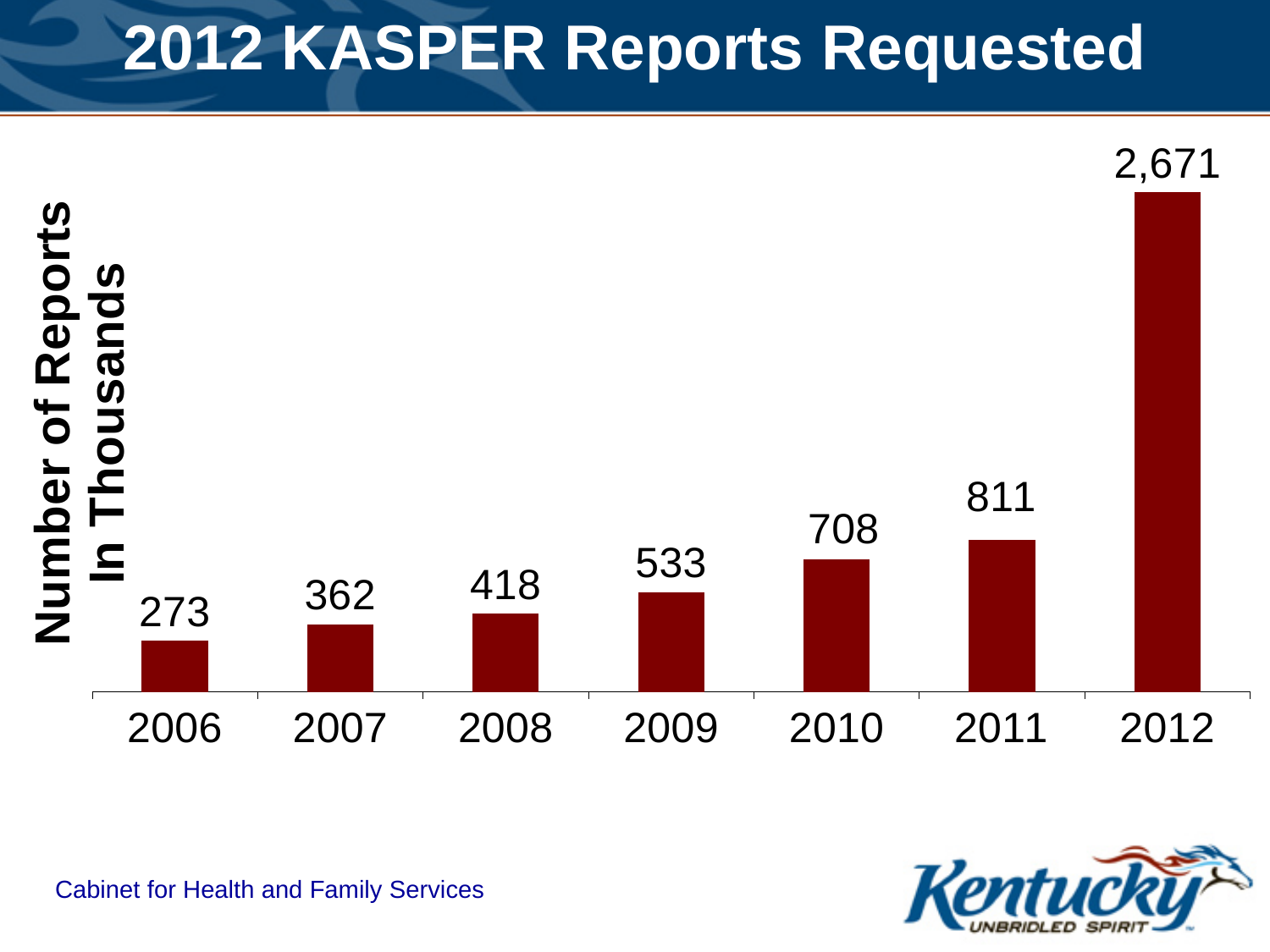
Do the values rise or fall from 2006 to 2012? Rise What is the value for 2006? 273 What is the value for 2012? 2,671 What is the difference between the values for 2010 and 2009? 175 What is the value for 2009? 533 What kind of chart is shown on the slide? Bar chart How many years are shown on the x axis? 7 Which year has the highest number of reports? 2012 Which year has the lowest number of reports? 2006 Which is larger, the value for 2008 or the value for 2007? 2008 What is the value for 2011? 811 What is the difference between the values for 2012 and 2011? 1,860